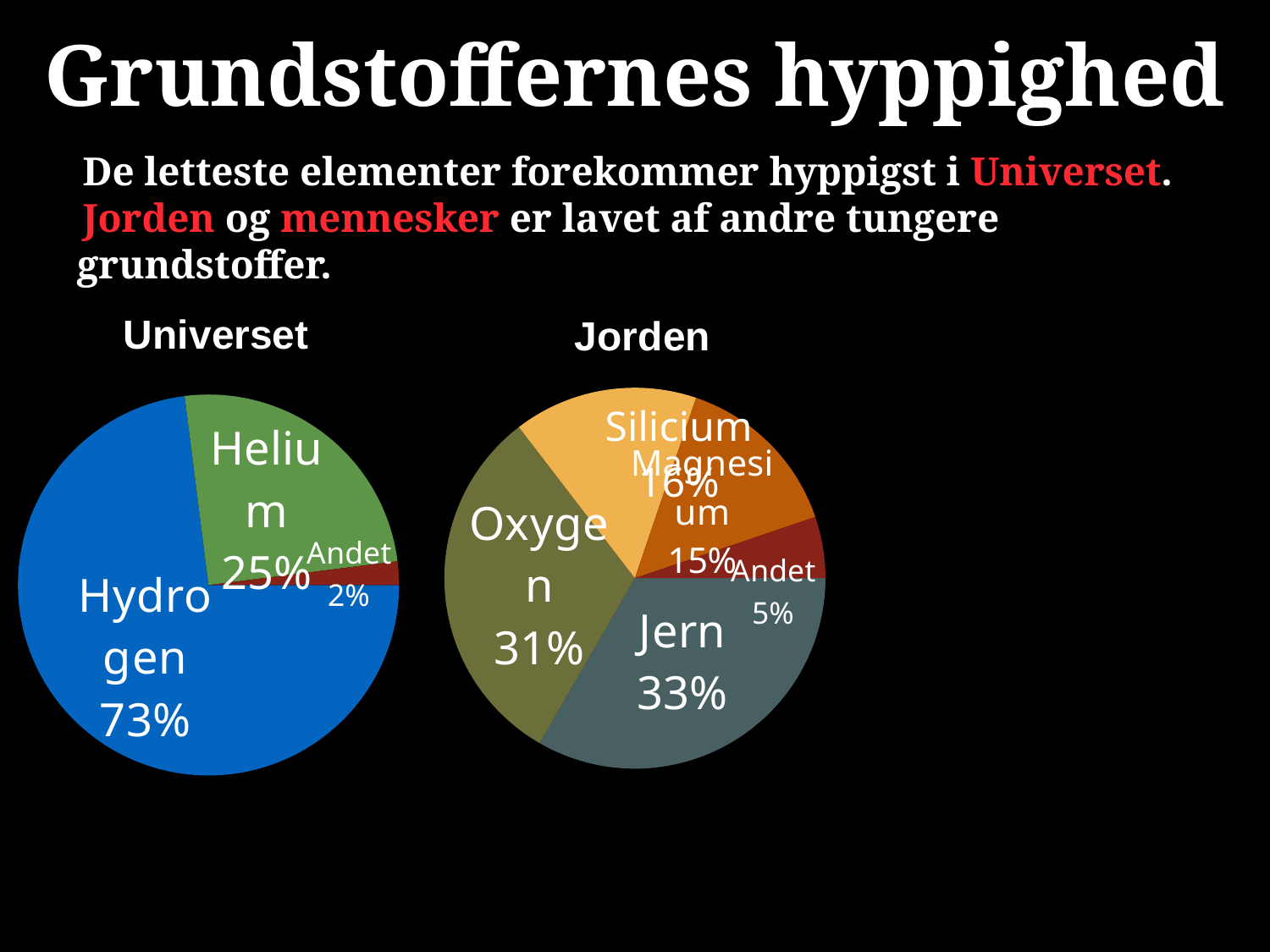
In the Universet pie chart, which slice is the largest? Hydrogen In the Universet pie chart, how many slices are there? 3 In the Universet pie chart, what share does Andet have? 2% In the Universet pie chart, what share does Helium have? 25% What kind of charts are shown on the slide? Pie charts In the Universet pie chart, what share does Hydrogen have? 73% In the Jorden pie chart, what share does Oxygen have? 31% In the Jorden pie chart, what is the difference between the shares of Jern and Oxygen? 2% In the Jorden pie chart, what share does Silicium have? 16% In the Jorden pie chart, which slice is the smallest? Andet In the Jorden pie chart, how many slices are there? 5 In the Jorden pie chart, what share does Jern have? 33%